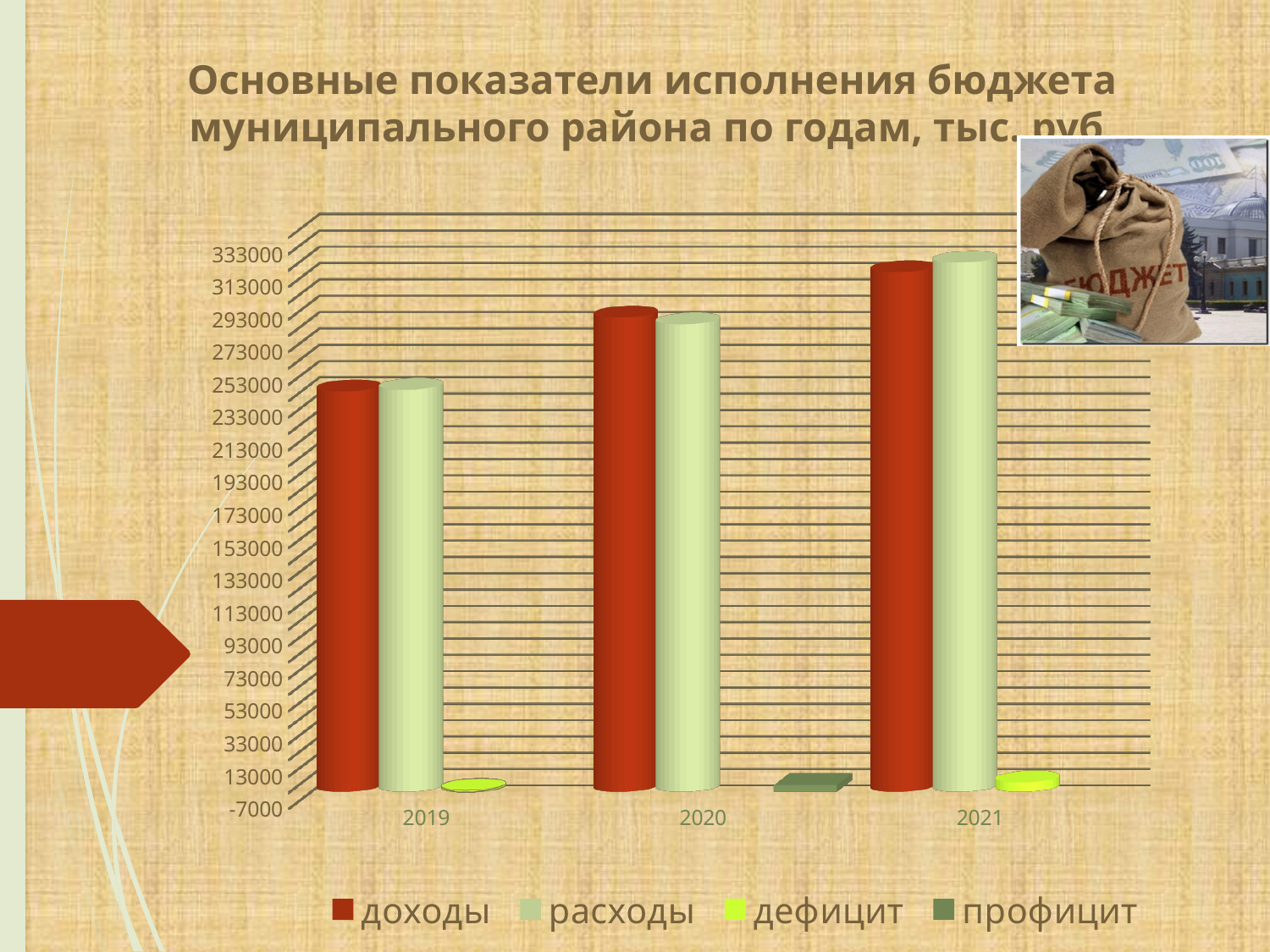
Is the value for доходы in 2019 greater or less than 273000? less Which series in the legend is shown in red? доходы Do the values for доходы rise or fall from 2019 to 2021? rise How many years (categories) are shown on the x axis of the chart? 3 Which is larger: расходы in 2021 or расходы in 2019? расходы in 2021 What kind of chart is shown on the slide? bar chart Which year has the lowest value for расходы? 2019 Is the value for доходы in 2021 greater or less than 293000? greater Is the value for доходы in 2019 greater or less than 213000? greater Which year has the highest value for доходы? 2021 How many series does the chart legend list? 4